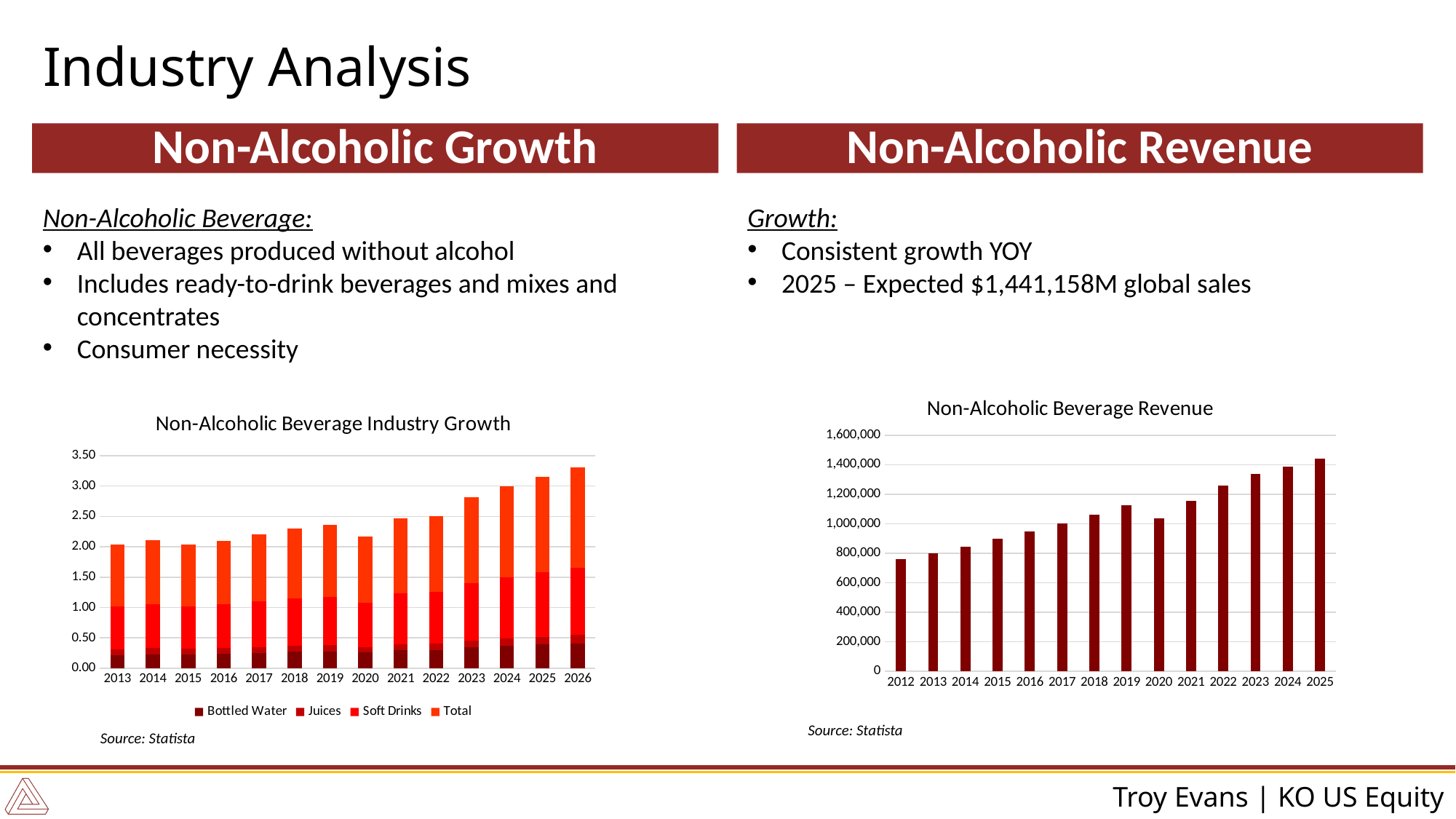
In the Non-Alcoholic Beverage Revenue chart, which year has the larger value, 2019 or 2020? 2019 In the Non-Alcoholic Beverage Revenue chart, is the value for 2022 greater or less than 1,200,000? greater How many series does the legend of the Non-Alcoholic Beverage Industry Growth chart list? 4 In the Non-Alcoholic Beverage Revenue chart, is the value for 2012 greater or less than 800,000? less In the Non-Alcoholic Beverage Industry Growth chart, is the total bar for 2026 greater or less than 3.00? greater What is the title of the chart on the left side of the slide? Non-Alcoholic Beverage Industry Growth In the Non-Alcoholic Beverage Revenue chart, which year has the highest revenue? 2025 In the Non-Alcoholic Beverage Industry Growth chart, which year has the tallest bar? 2026 What kind of chart is the Non-Alcoholic Beverage Revenue chart on the right? Bar chart In the Non-Alcoholic Beverage Revenue chart, which year has the lowest revenue? 2012 How many years are shown on the x axis of the Non-Alcoholic Beverage Industry Growth chart on the left? 14